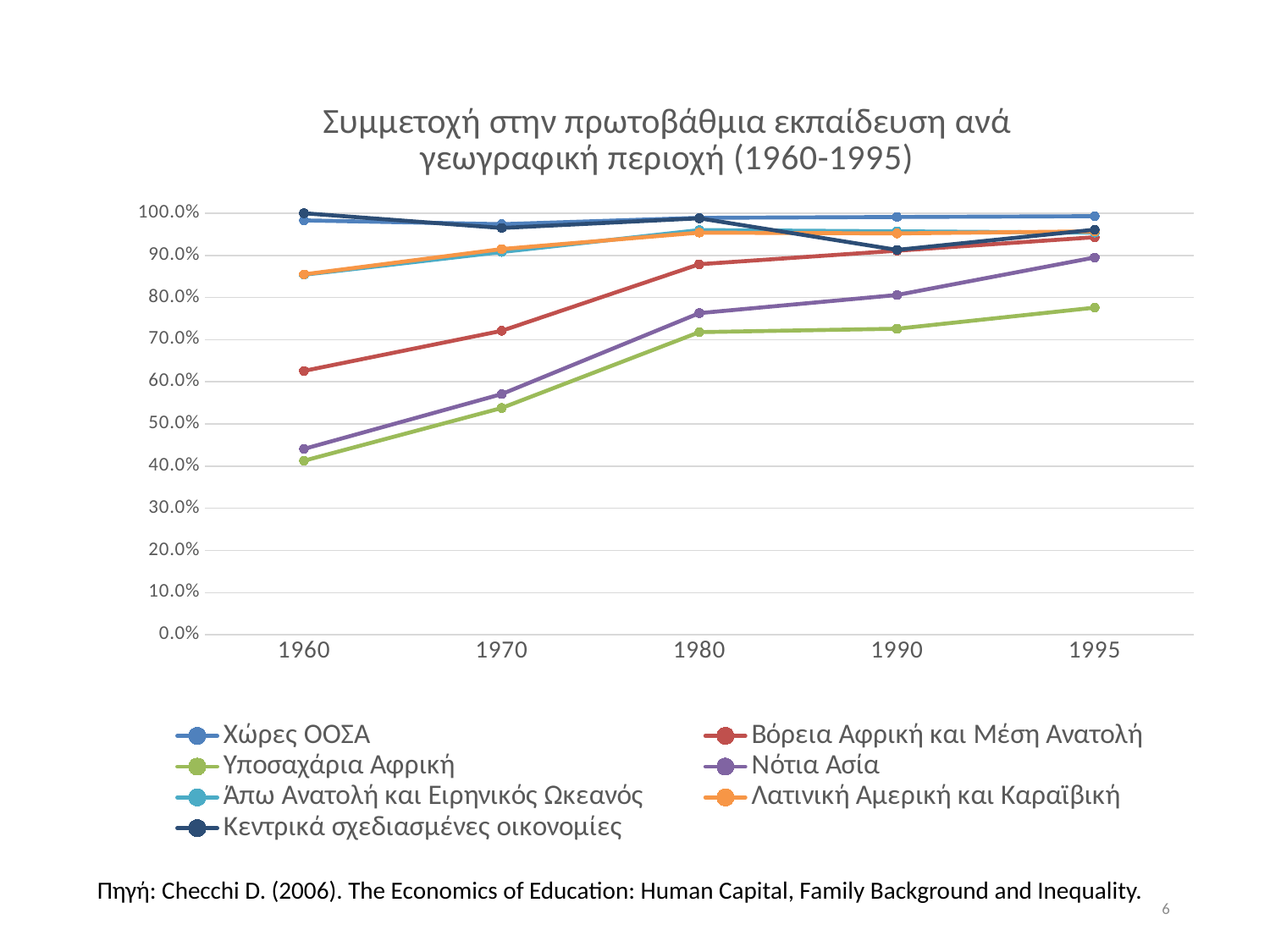
What is the title of the chart? Συμμετοχή στην πρωτοβάθμια εκπαίδευση ανά γεωγραφική περιοχή (1960-1995) Does the value for Κεντρικά σχεδιασμένες οικονομίες rise or fall from 1980 to 1990? fall What kind of chart is shown on the slide? line chart Is the value for Νότια Ασία in 1970 greater or less than 50.0%? greater How many series does the legend list? 7 In 1980, which is higher: Βόρεια Αφρική και Μέση Ανατολή or Νότια Ασία? Βόρεια Αφρική και Μέση Ανατολή Which series has the lowest value in 1995? Υποσαχάρια Αφρική Is the value for Υποσαχάρια Αφρική in 1960 greater or less than 50.0%? less Is the value for Βόρεια Αφρική και Μέση Ανατολή in 1960 greater or less than 60.0%? greater Does the value for Υποσαχάρια Αφρική rise or fall from 1960 to 1995? rise How many years are shown on the x axis? 5